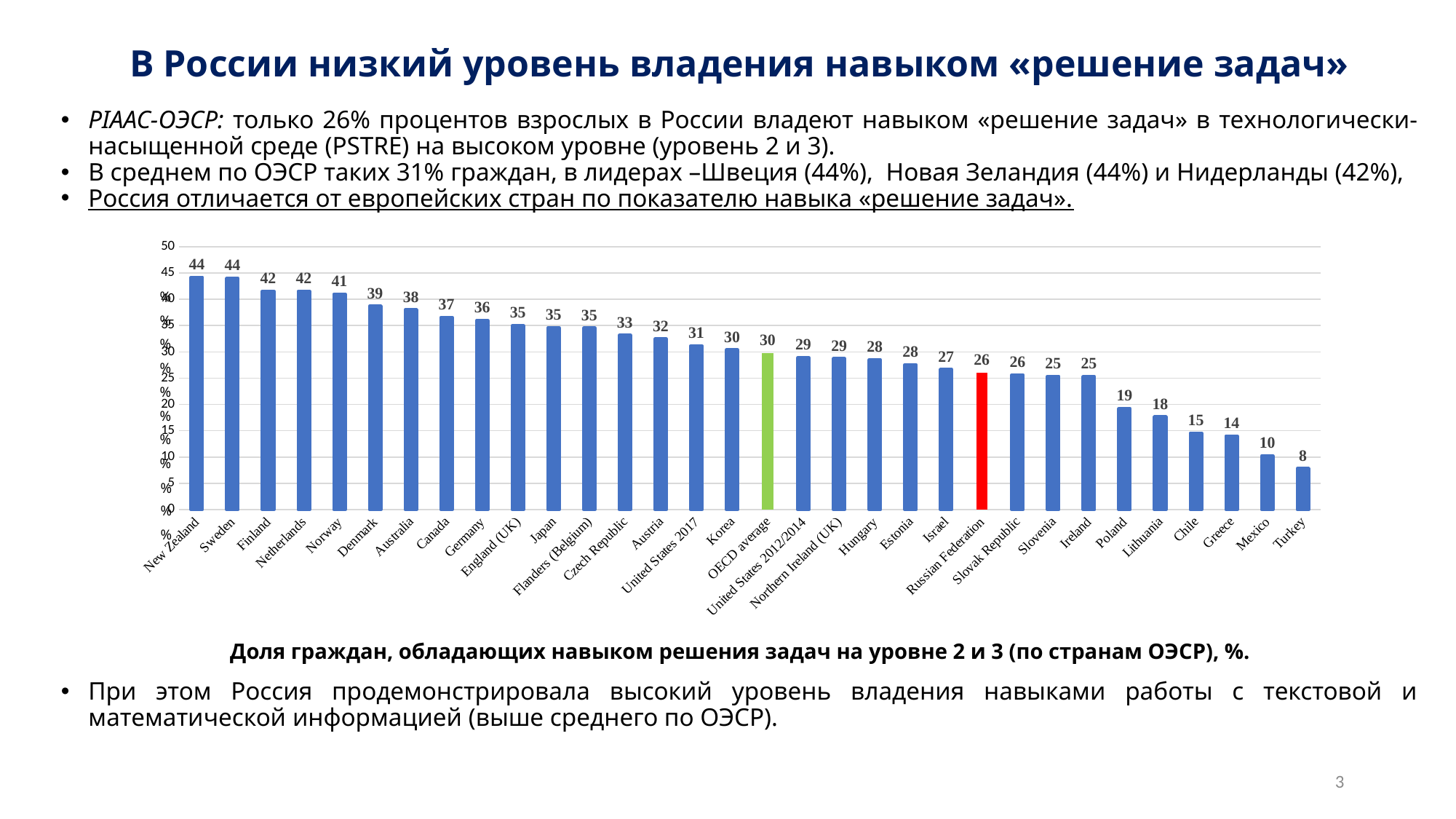
What kind of chart is shown on the slide? bar chart Which has a larger value, Germany or Japan? Germany What is the value for OECD average? 30 What is the value for Russian Federation? 26 What colour is the bar for Russian Federation? red What is the difference between the values for Sweden and Russian Federation? 18 How many countries/categories are shown on the chart? 32 Which country has the lowest value? Turkey Do the values rise or fall from left to right along the x axis? fall What is the difference between the OECD average and the value for Russian Federation? 4 What is the value for Mexico? 10 Is the value for Poland greater or less than 20? less